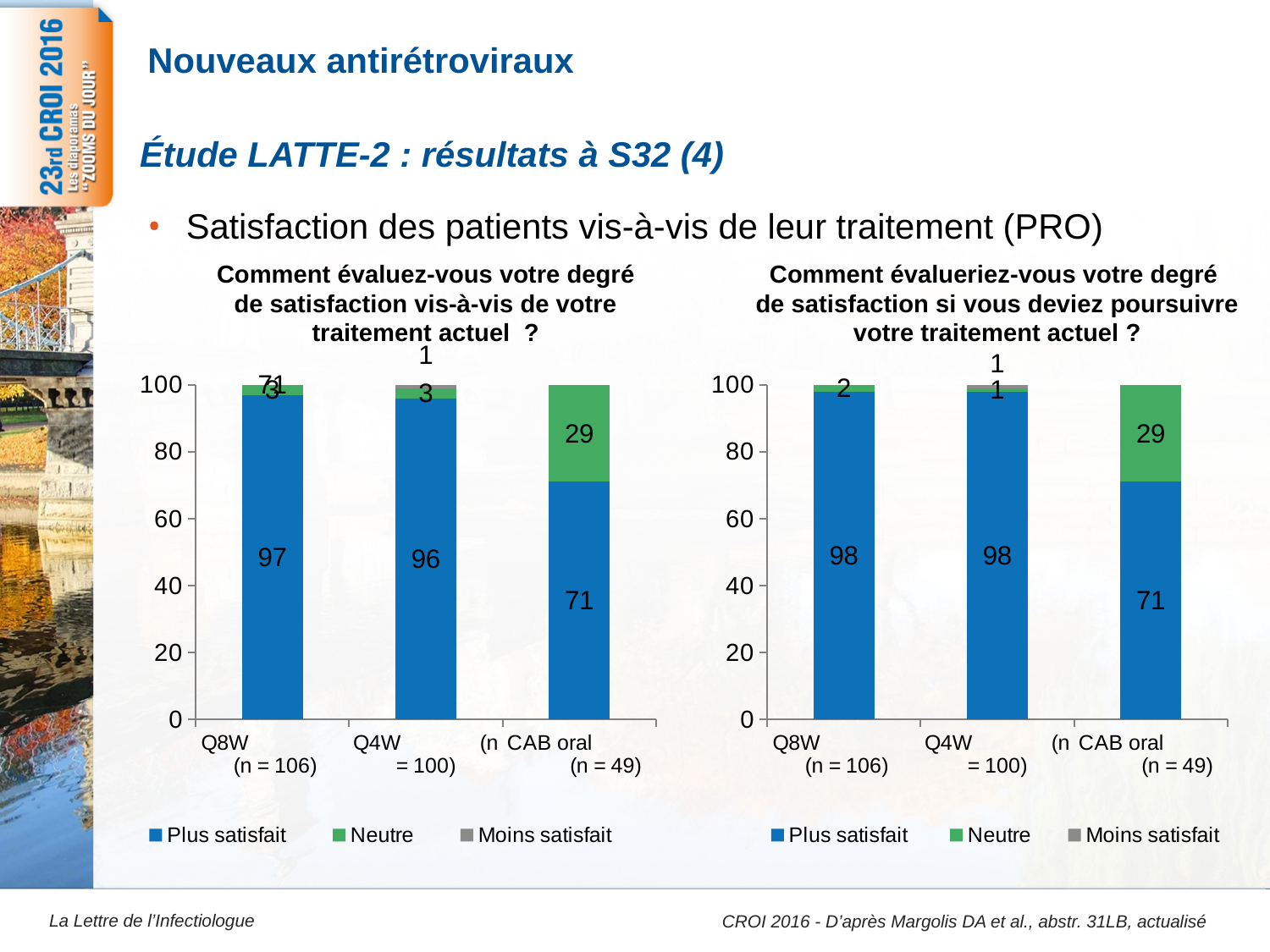
In the left chart, which is larger: the "Plus satisfait" value for Q8W or for CAB oral? Q8W What kind of chart is the left chart? Stacked bar chart In the right chart, what is the value of "Plus satisfait" for CAB oral? 71 In the right chart ("Comment évalueriez-vous votre degré de satisfaction si vous deviez poursuivre votre traitement actuel ?"), what is the value of "Plus satisfait" for Q8W? 98 In the left chart, what is the value of "Neutre" for CAB oral? 29 In the left chart, what is the value of "Plus satisfait" for Q4W? 96 In the left chart ("Comment évaluez-vous votre degré de satisfaction vis-à-vis de votre traitement actuel ?"), what is the value of "Plus satisfait" for Q8W? 97 In the right chart, what is the difference between the "Plus satisfait" values for Q8W and CAB oral? 27 In the left chart, which category has the lowest "Plus satisfait" value? CAB oral How many series does the legend of the right chart list? 3 How many categories are shown on the x axis of the left chart? 3 In the right chart, what is the value of "Neutre" for Q8W? 2